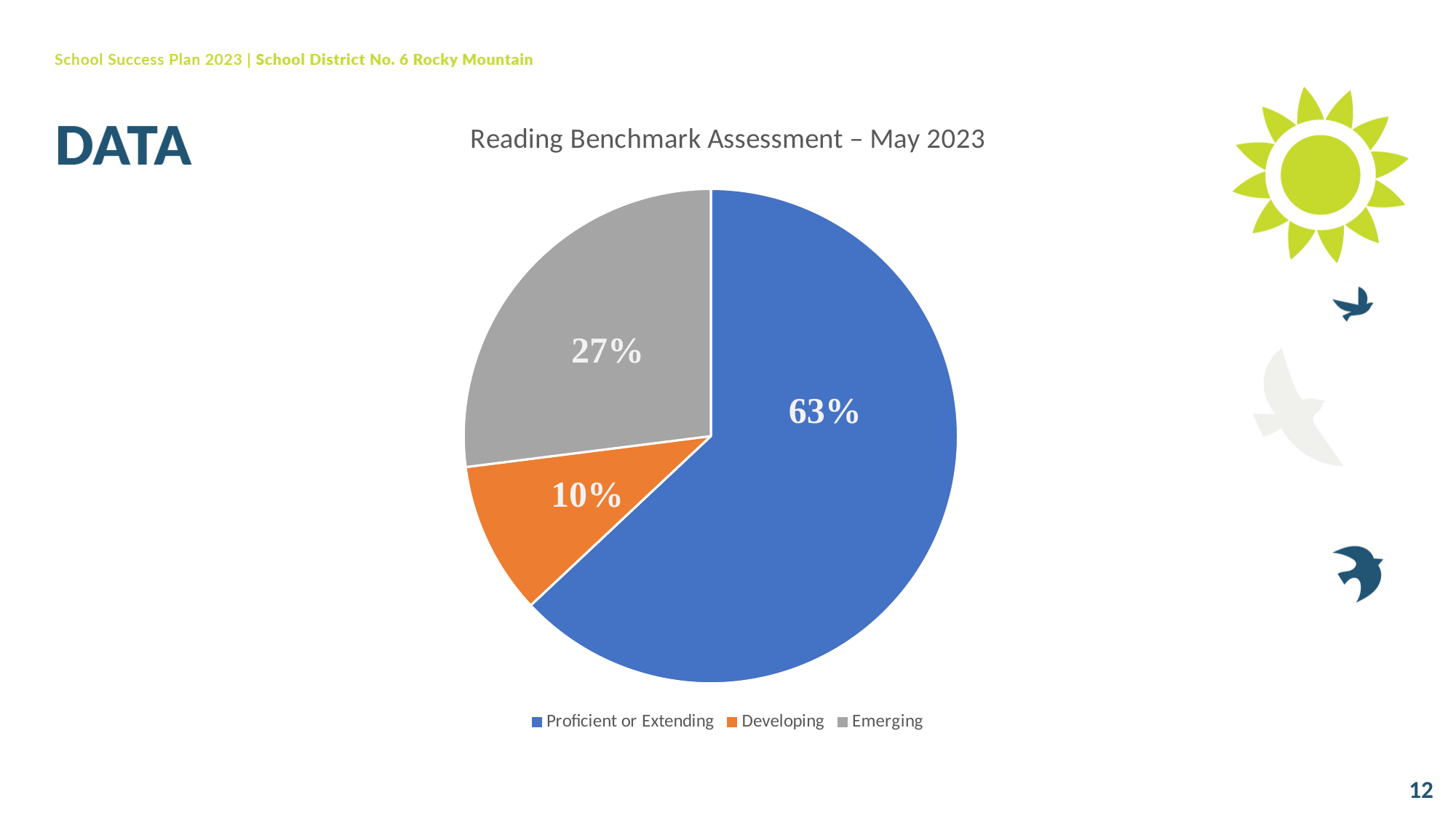
What percentage of students are Emerging? 27% What is the difference in percentage points between Proficient or Extending and Emerging? 36 What percentage of students are Proficient or Extending? 63% What is the title of the chart? Reading Benchmark Assessment – May 2023 How many categories does the pie chart show? 3 Which colour represents the Developing category in the legend? orange What type of chart is shown on the slide? pie chart What is the difference in percentage points between Emerging and Developing? 17 Which category has the smallest share of the pie? Developing Which category has the largest share of the pie? Proficient or Extending What percentage of students are Developing? 10% Which is larger, the Emerging share or the Developing share? Emerging